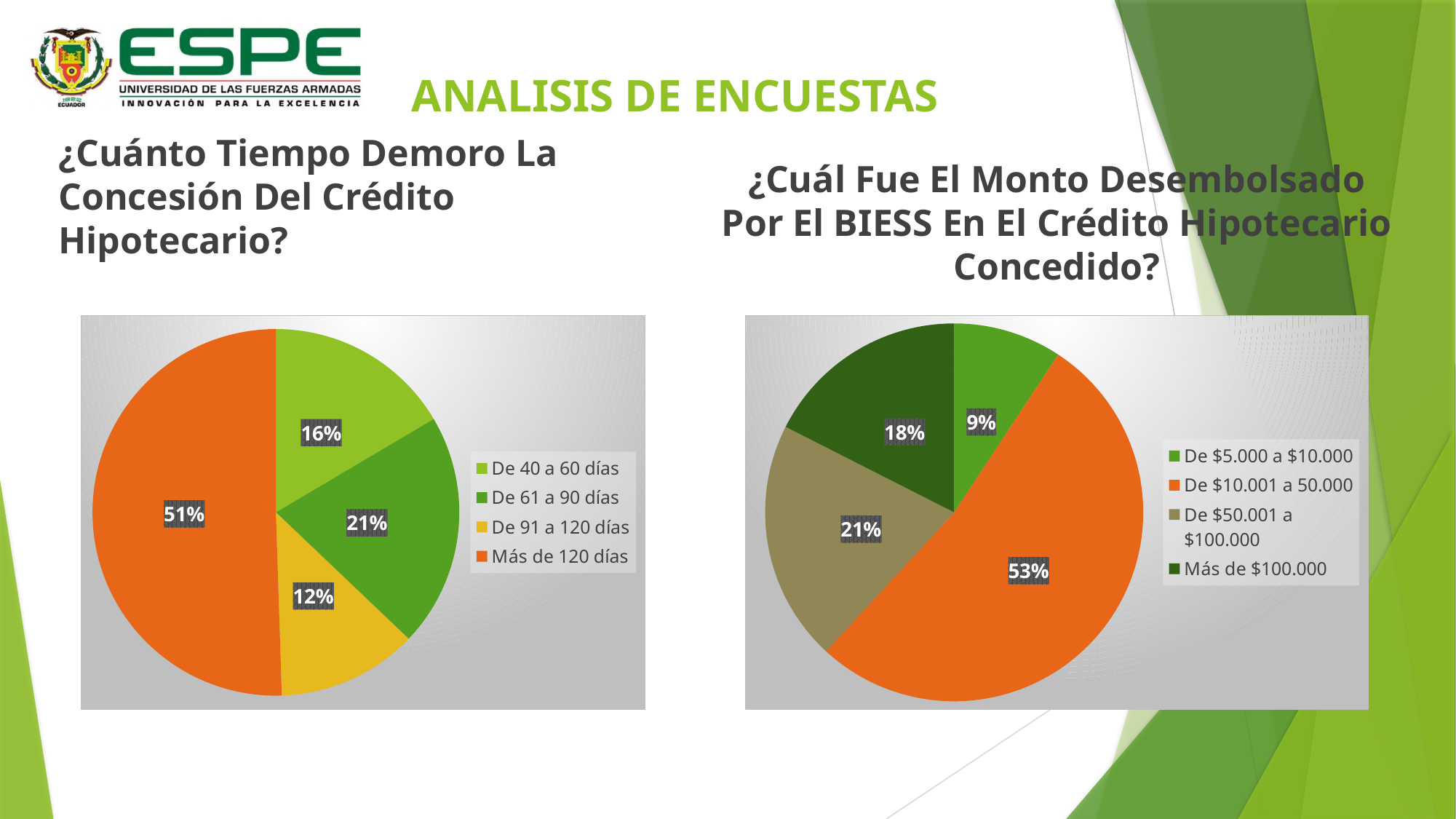
In the left pie chart (¿Cuánto Tiempo Demoro La Concesión Del Crédito Hipotecario?), what share is labelled for 'Más de 120 días'? 51% In the right pie chart (¿Cuál Fue El Monto Desembolsado Por El BIESS En El Crédito Hipotecario Concedido?), what is the difference between the shares for 'De $10.001 a 50.000' and 'De $5.000 a $10.000'? 44% In the left pie chart (¿Cuánto Tiempo Demoro La Concesión Del Crédito Hipotecario?), what share is labelled for 'De 91 a 120 días'? 12% In the right pie chart (¿Cuál Fue El Monto Desembolsado Por El BIESS En El Crédito Hipotecario Concedido?), what share is labelled for 'Más de $100.000'? 18% In the right pie chart (¿Cuál Fue El Monto Desembolsado Por El BIESS En El Crédito Hipotecario Concedido?), what share is labelled for 'De $10.001 a 50.000'? 53% In the left pie chart (¿Cuánto Tiempo Demoro La Concesión Del Crédito Hipotecario?), which category has the largest slice? Más de 120 días In the right pie chart (¿Cuál Fue El Monto Desembolsado Por El BIESS En El Crédito Hipotecario Concedido?), which is larger: the share for 'De $50.001 a $100.000' or for 'Más de $100.000'? De $50.001 a $100.000 In the right pie chart (¿Cuál Fue El Monto Desembolsado Por El BIESS En El Crédito Hipotecario Concedido?), which category has the smallest slice? De $5.000 a $10.000 In the left pie chart (¿Cuánto Tiempo Demoro La Concesión Del Crédito Hipotecario?), which category has the smallest slice? De 91 a 120 días What kind of chart is used on the right side of the slide? Pie chart In the left pie chart (¿Cuánto Tiempo Demoro La Concesión Del Crédito Hipotecario?), how many categories does the legend list? 4 In the left pie chart (¿Cuánto Tiempo Demoro La Concesión Del Crédito Hipotecario?), what is the difference between the shares for 'De 61 a 90 días' and 'De 40 a 60 días'? 5%